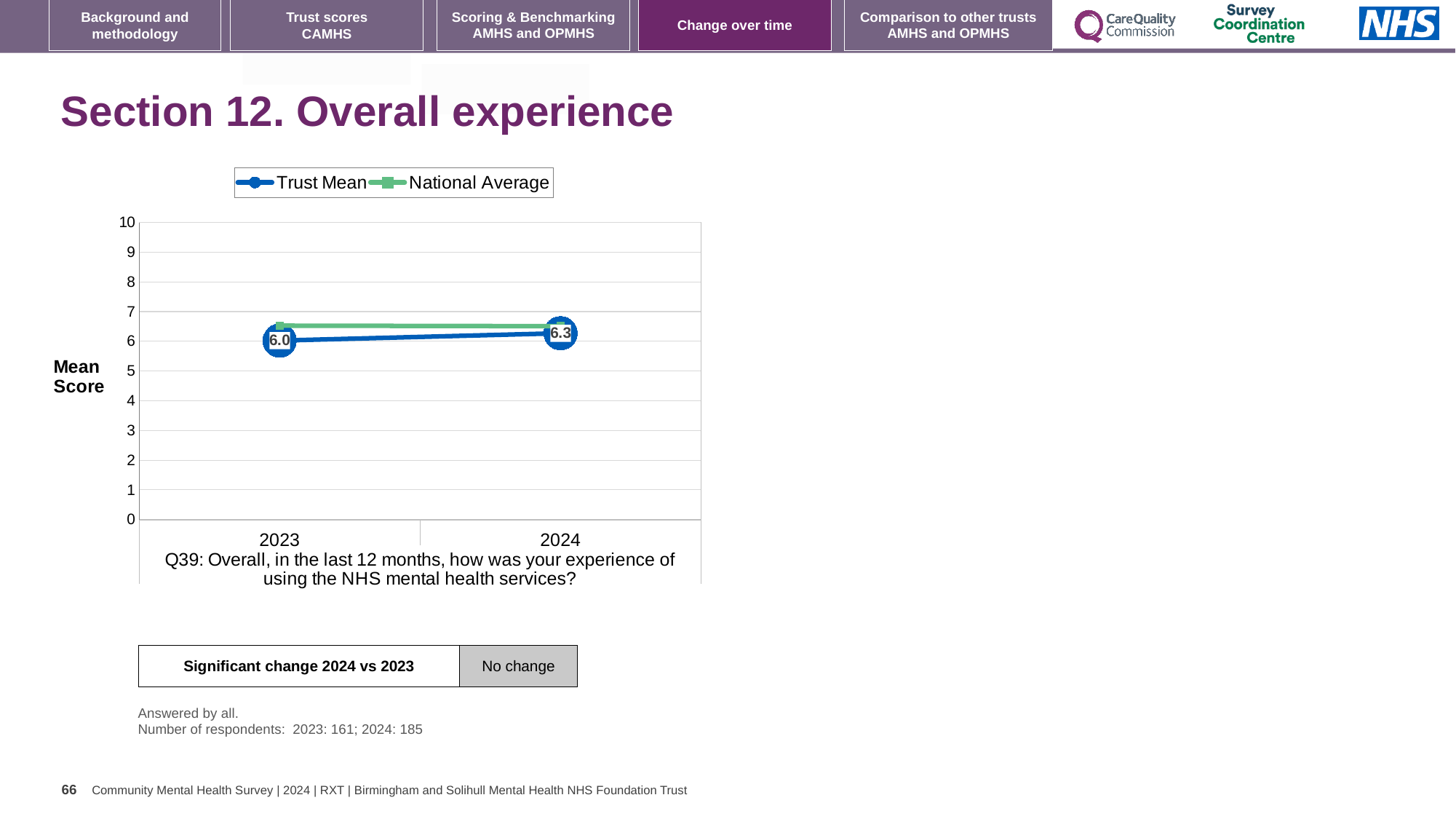
What kind of chart is shown on the slide? line chart What is the Trust Mean score for 2023? 6.0 What is the Trust Mean score for 2024? 6.3 In which year is the Trust Mean score higher, 2023 or 2024? 2024 What is the label of the y axis of the chart? Mean Score How many years are plotted on the x axis of the chart? 2 Does the Trust Mean rise or fall from 2023 to 2024? rise Is the National Average value for 2024 greater or less than 7? less Is the National Average value for 2023 greater or less than 6? greater What is the difference between the Trust Mean scores for 2024 and 2023? 0.3 How many series does the chart legend list? 2 In 2023, which is higher, the Trust Mean or the National Average? National Average